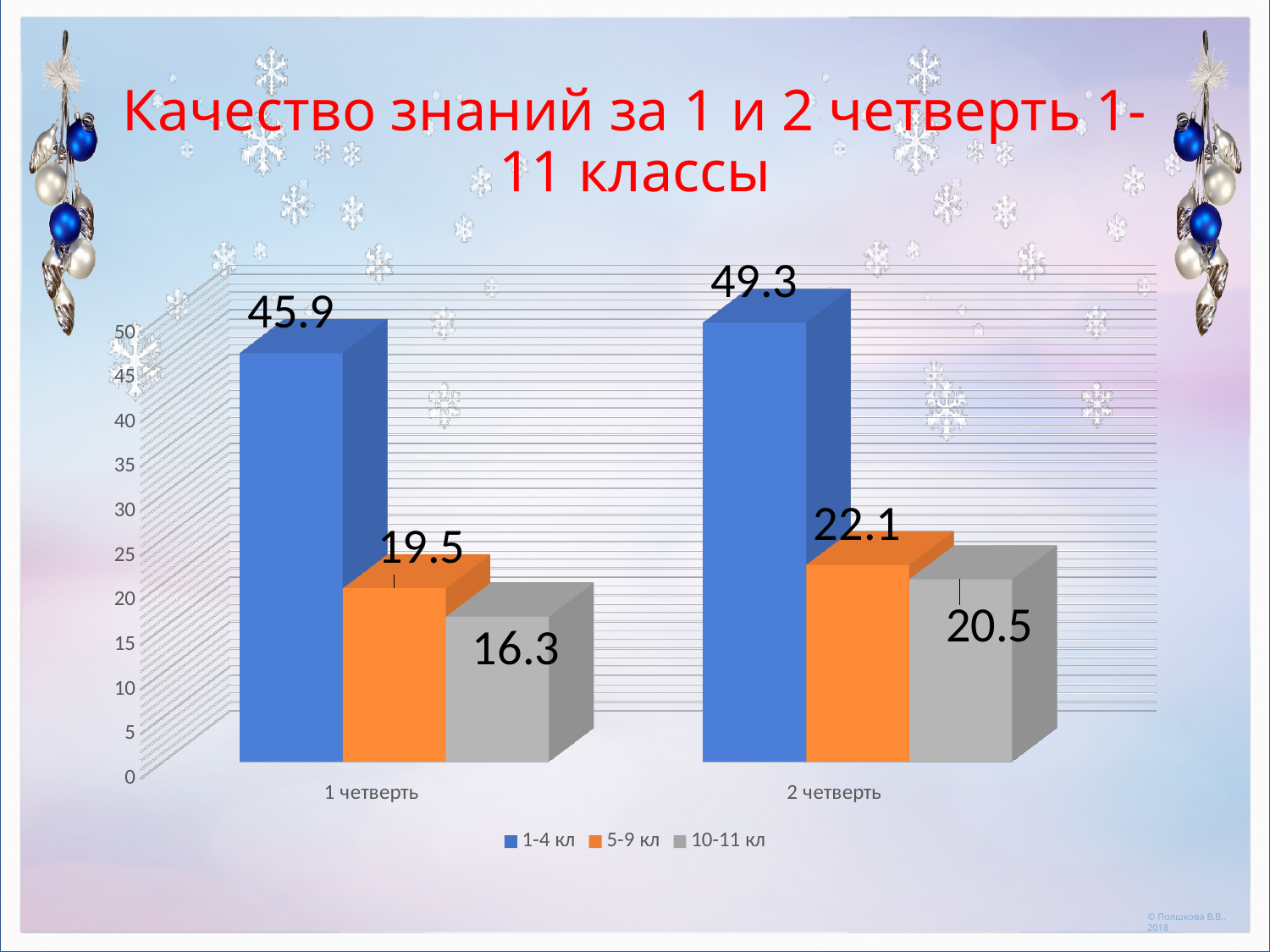
What is the value for 1-4 кл in 1 четверть? 45.9 Which is larger: 5-9 кл in 1 четверть or 10-11 кл in 2 четверть? 10-11 кл in 2 четверть Does the value for 10-11 кл rise or fall from 1 четверть to 2 четверть? Rise Which series has the highest value in 2 четверть? 1-4 кл How many series does the legend list? 3 What is the value for 10-11 кл in 1 четверть? 16.3 How many categories are shown on the x axis? 2 What is the value for 5-9 кл in 2 четверть? 22.1 What is the value for 1-4 кл in 2 четверть? 49.3 Which series has the lowest value in 1 четверть? 10-11 кл What kind of chart is shown on the slide? Bar chart What is the difference between the 1-4 кл values in 2 четверть and 1 четверть? 3.4